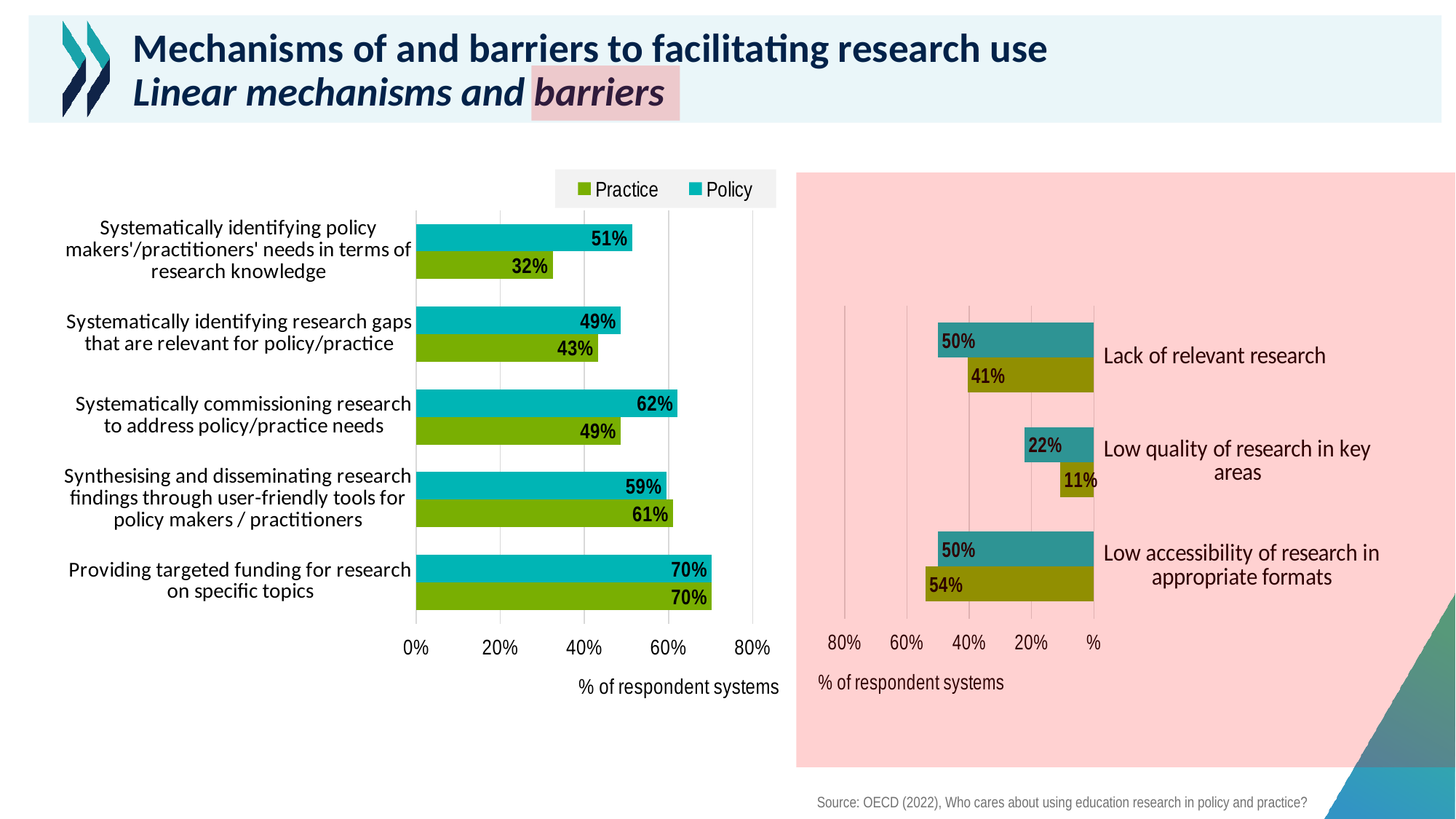
In the right chart (barriers), what is the value of the lower (olive) bar for 'Low accessibility of research in appropriate formats'? 54% In the right chart (barriers), what is the value of the upper (teal) bar for 'Low quality of research in key areas'? 22% In the left chart (mechanisms), what is the Practice value for 'Systematically identifying policy makers'/practitioners' needs in terms of research knowledge'? 32% In the left chart (mechanisms), for 'Synthesising and disseminating research findings through user-friendly tools for policy makers / practitioners', which series has the larger value, Practice or Policy? Practice In the left chart (mechanisms), how many mechanisms (categories) are shown? 5 In the left chart (mechanisms), what is the Policy value for 'Systematically commissioning research to address policy/practice needs'? 62% In the left chart (mechanisms), what is the difference between the Policy and Practice values for 'Systematically identifying research gaps that are relevant for policy/practice'? 6% In the left chart (mechanisms), which mechanism has the highest Policy value? Providing targeted funding for research on specific topics In the left chart (mechanisms), how many series does the legend list? 2 In the right chart (barriers), what is the difference between the two bars for 'Lack of relevant research'? 9% What kind of chart is the right chart (barriers)? Bar chart In the left chart (mechanisms), which mechanism has the lowest Practice value? Systematically identifying policy makers'/practitioners' needs in terms of research knowledge